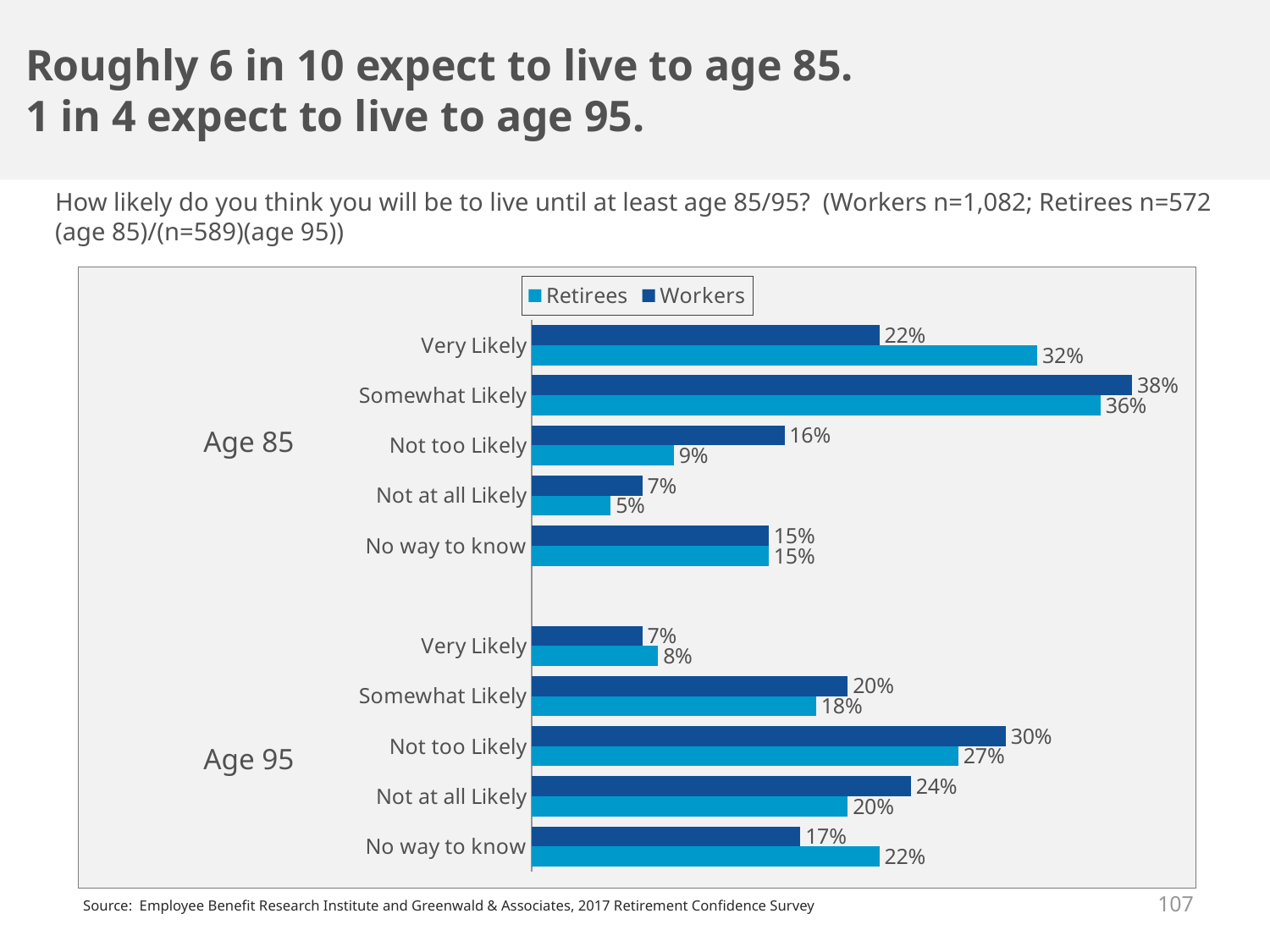
For age 85, which response category has the highest value among Workers? Somewhat Likely What percentage of Workers say they are Somewhat Likely to live to age 85? 38% What percentage of Retirees say they are Very Likely to live to age 85? 32% Which series is shown in the lighter blue colour? Retirees For age 85, which is larger: the Workers value for Not too Likely or the Retirees value for Not too Likely? Workers For age 85, what is the difference between the Retirees and Workers values for Very Likely? 10% For age 95, what is the difference between the Workers and Retirees values for Not at all Likely? 4% What percentage of Workers say they are Not too Likely to live to age 95? 30% What percentage of Retirees answered No way to know for age 95? 22% How many series does the legend list? 2 What kind of chart is shown on the slide? Bar chart For age 95, which response category has the lowest value among Retirees? Very Likely